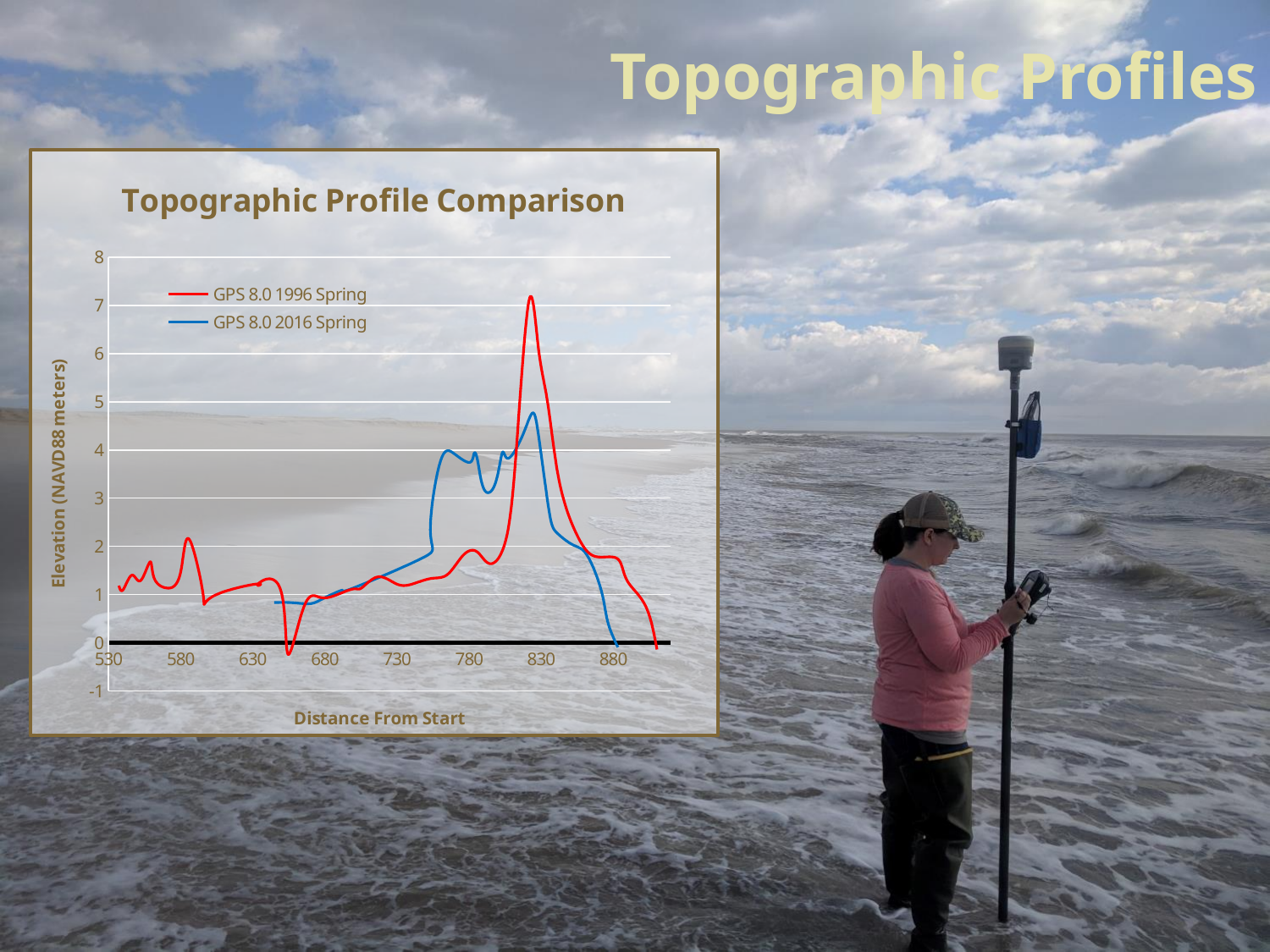
What is the title of the chart? Topographic Profile Comparison Does the GPS 8.0 1996 Spring series rise or fall between distances 830 and 880? fall Is the elevation of the GPS 8.0 2016 Spring series at a distance of 780 greater or less than 3? greater Is the peak elevation of the GPS 8.0 2016 Spring series greater or less than 5? less Is the elevation of the GPS 8.0 1996 Spring series at a distance of 680 greater or less than 2? less Which series has the higher elevation at a distance of 760, GPS 8.0 1996 Spring or GPS 8.0 2016 Spring? GPS 8.0 2016 Spring How many series does the legend of the chart list? 2 What kind of chart is shown on the slide? line chart Which series reaches the highest elevation on the chart? GPS 8.0 1996 Spring What is the label of the vertical axis of the chart? Elevation (NAVD88 meters)